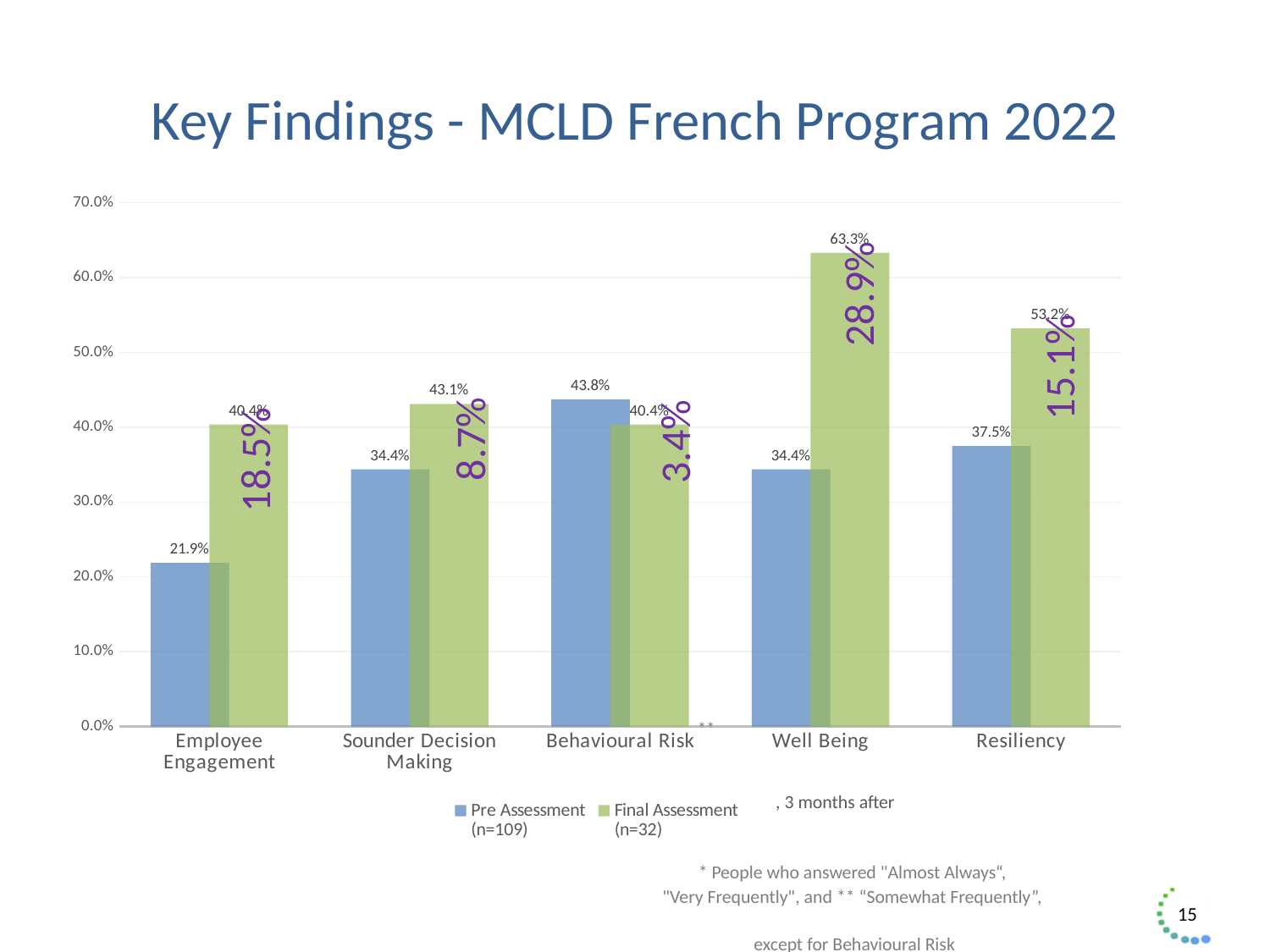
Which category has the lowest Pre Assessment value? Employee Engagement How many series does the legend list? 2 What is the difference between the Final Assessment and Pre Assessment values for Well Being? 28.9% How many categories are shown on the x axis? 5 What is the Final Assessment value for Resiliency? 53.2% What is the Pre Assessment value for Employee Engagement? 21.9% What is the Final Assessment value for Well Being? 63.3% For Behavioural Risk, which is larger: the Pre Assessment value or the Final Assessment value? Pre Assessment Which category has the highest Final Assessment value? Well Being What is the sample size (n) for the Final Assessment series according to the legend? n=32 What is the Pre Assessment value for Behavioural Risk? 43.8% What kind of chart is shown on the slide? Bar chart